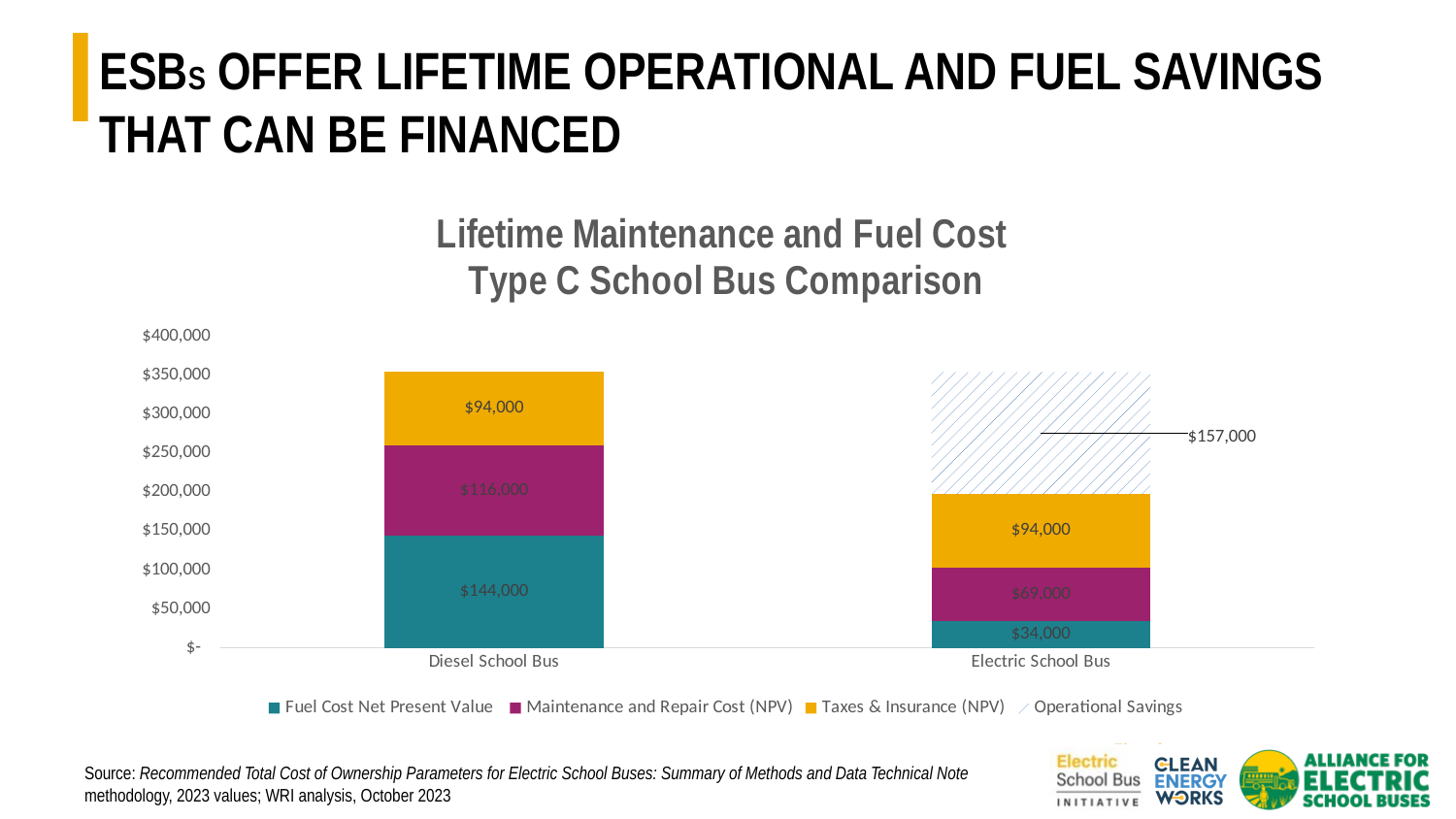
What is the Fuel Cost Net Present Value for the Diesel School Bus? $144,000 What is the Operational Savings value shown for the Electric School Bus? $157,000 What is the total of the Diesel School Bus stacked bar? $354,000 What is the difference in Maintenance and Repair Cost (NPV) between the Diesel School Bus and the Electric School Bus? $47,000 What is the Maintenance and Repair Cost (NPV) for the Electric School Bus? $69,000 What kind of chart is shown on the slide? Stacked bar chart What is the title of the chart? Lifetime Maintenance and Fuel Cost Type C School Bus Comparison How many series does the legend list? 4 What is the difference in Fuel Cost Net Present Value between the Diesel School Bus and the Electric School Bus? $110,000 Which bus has the larger Maintenance and Repair Cost (NPV), the Diesel School Bus or the Electric School Bus? Diesel School Bus What is the Fuel Cost Net Present Value for the Electric School Bus? $34,000 What is the Taxes & Insurance (NPV) value for the Diesel School Bus? $94,000